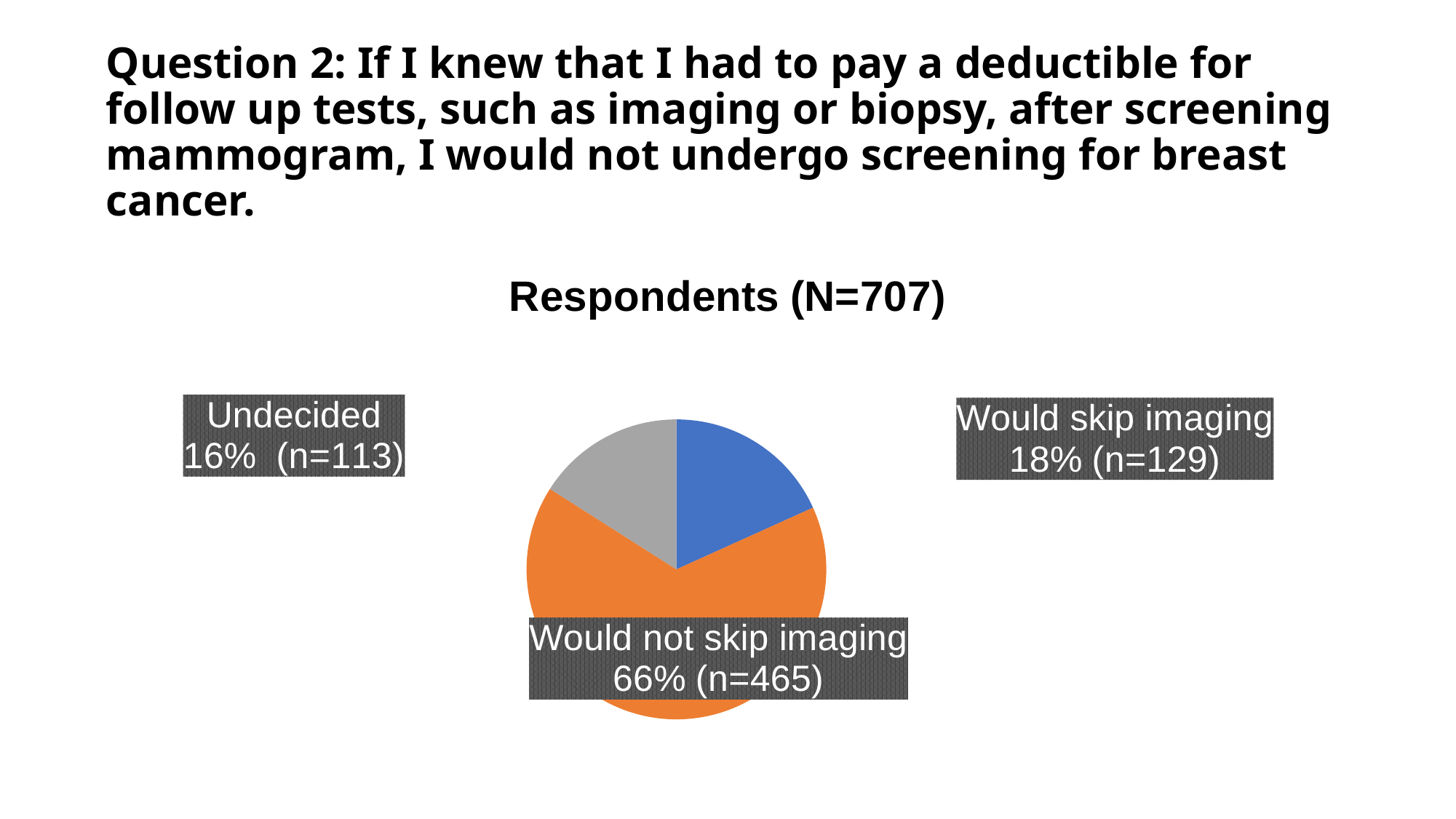
What percentage of respondents would skip imaging? 18% What kind of chart is shown on the slide? pie chart How many respondents would not skip imaging? 465 How many respondents were undecided? 113 How many slices does the pie chart have? 3 What percentage of respondents were undecided? 16% Which is larger: the share for 'Would skip imaging' or the share for 'Undecided'? Would skip imaging Which category has the largest share of the pie? Would not skip imaging What is the difference in number of respondents between 'Would skip imaging' and 'Undecided'? 16 What colour is the 'Would not skip imaging' slice? orange What is the title of the chart? Respondents (N=707) Which category has the smallest share of the pie? Undecided